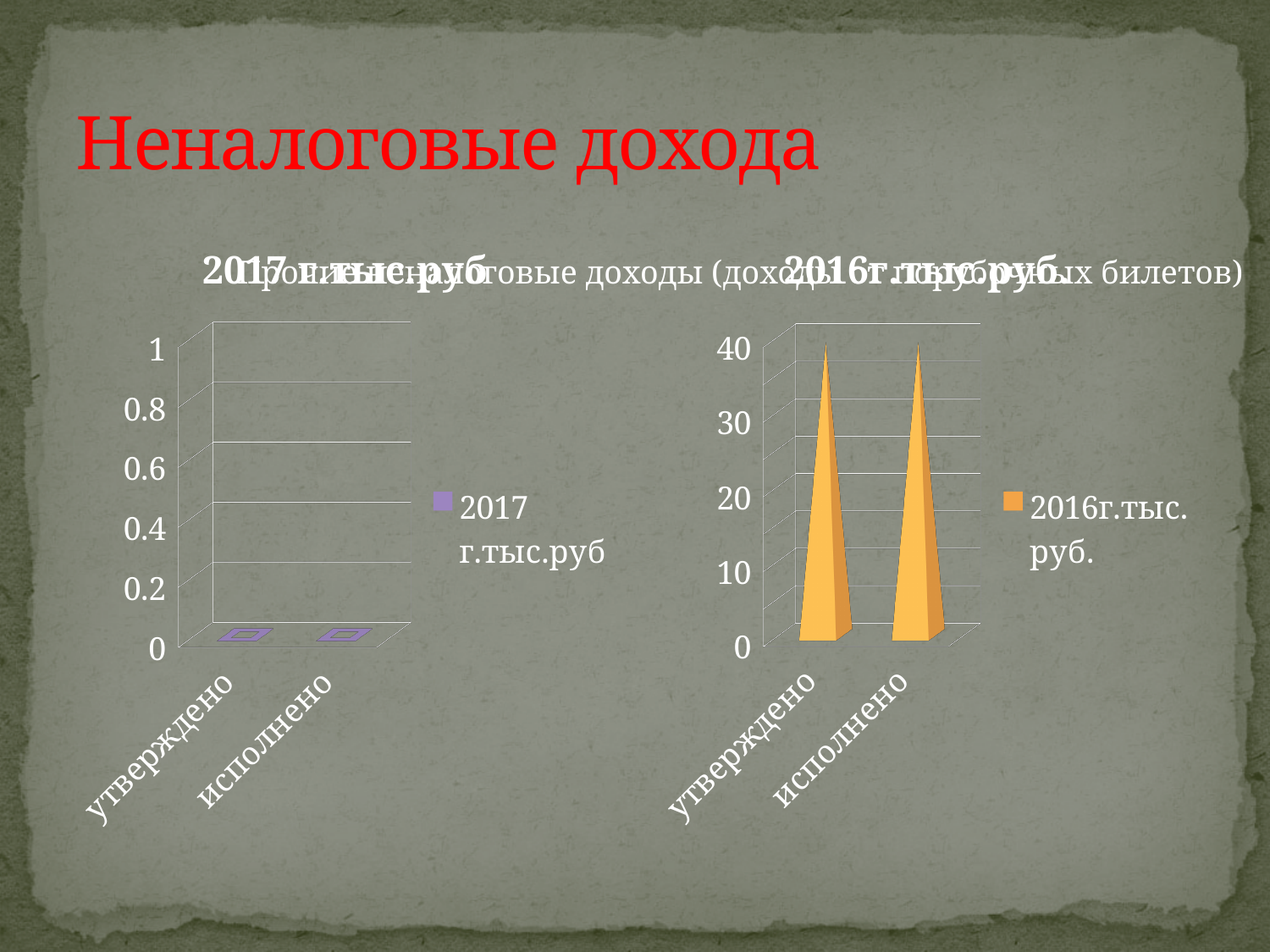
On the left chart, how many series does the legend list? 1 On the left chart, how many categories are shown on the x axis? 2 On the right chart, how many categories are shown on the x axis? 2 What kind of chart is the left chart? bar chart On the right chart, is the value for утверждено greater or less than 30? greater On the left chart, is the value for исполнено greater or less than 0.4? less On the left chart, is the value for утверждено greater or less than 0.2? less What is the highest tick value on the vertical axis of the right chart? 40 What is the legend entry on the right chart? 2016г.тыс.руб. What kind of chart is the right chart? bar chart On the right chart, how many series does the legend list? 1